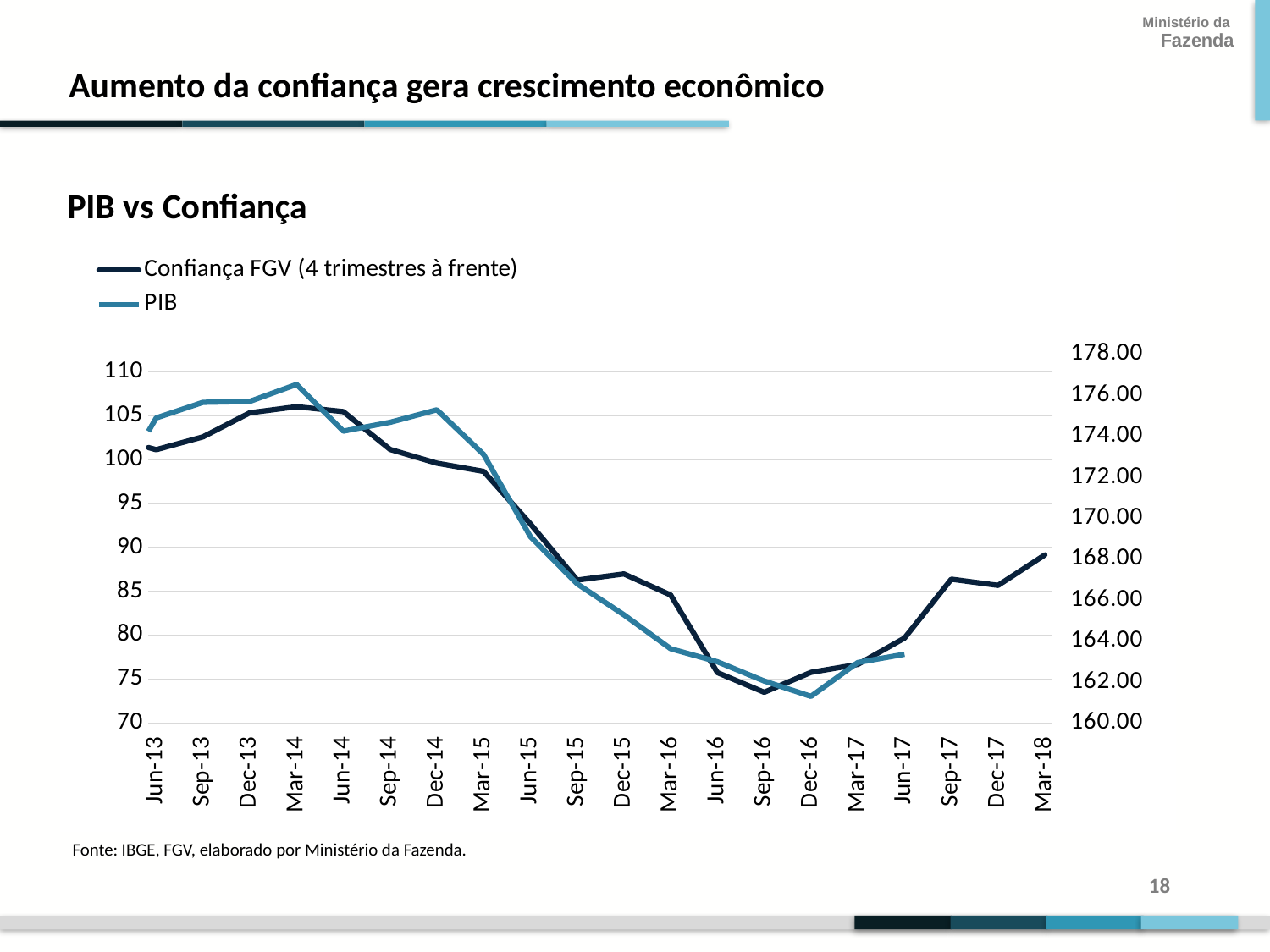
Does the Confiança FGV line rise or fall between Sep-16 and Mar-18? rise Is the Confiança FGV value at Mar-14 higher or lower than its value at Sep-16? higher Reading the Confiança FGV line against the left axis, is its value at Mar-18 greater or less than 85? greater Does the Confiança FGV line rise or fall between Mar-14 and Sep-16? fall What are the two series named in the legend? Confiança FGV (4 trimestres à frente) and PIB How many quarterly categories are shown on the x axis? 20 At which quarter does the PIB line reach its highest point? Mar-14 How many series does the legend list? 2 At which quarter does the PIB line reach its lowest point? Dec-16 At which quarter does the Confiança FGV line reach its lowest point? Sep-16 What kind of chart is shown on the slide? line chart What is the title of the chart? PIB vs Confiança